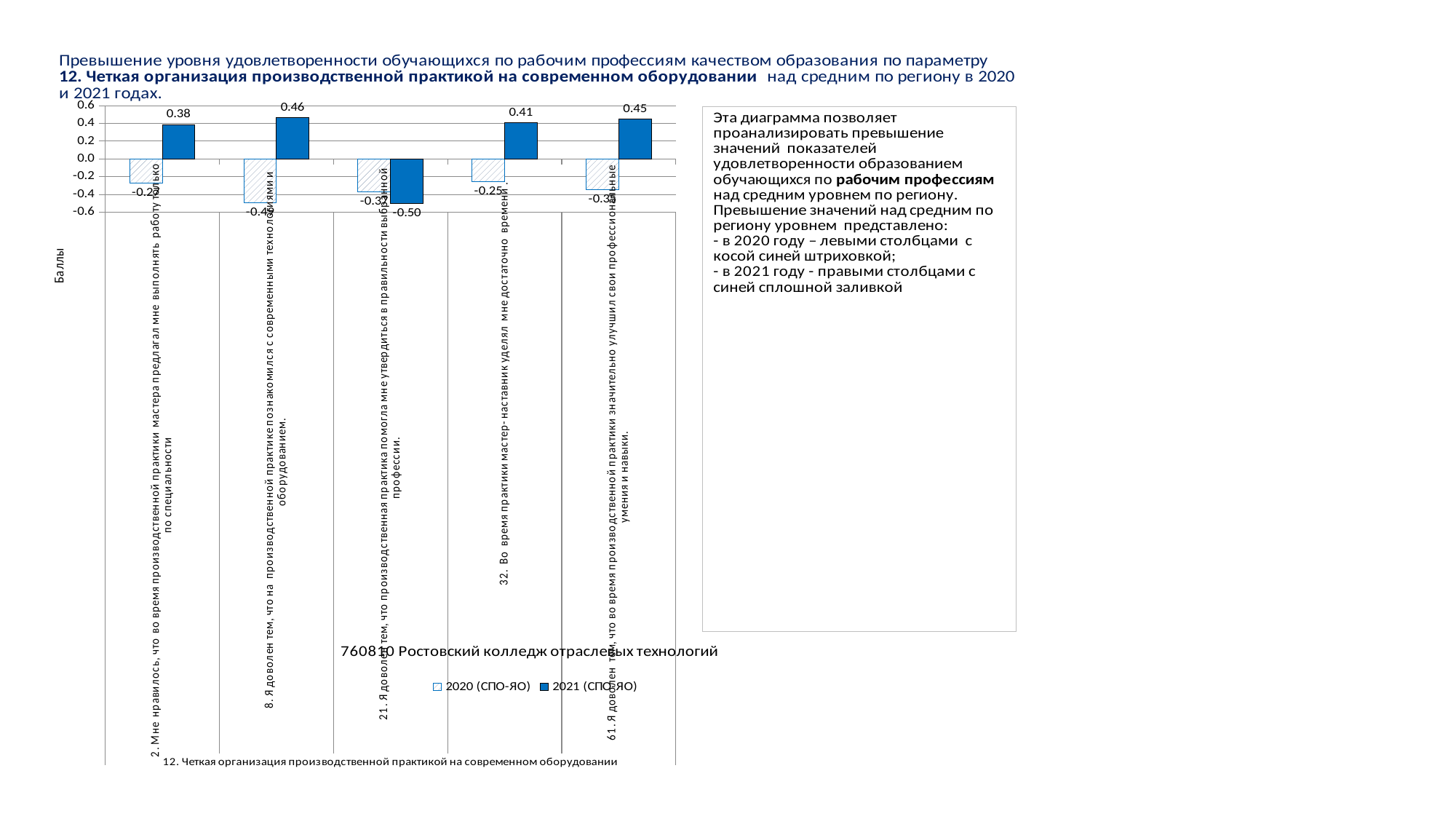
What is the 2021 (СПО-ЯО) value for category 21 ("Я доволен тем, что производственная практика помогла мне утвердиться в правильности выбранной профессии")? -0.50 How many categories (questions) are plotted on the chart? 5 What is the difference between the 2021 (СПО-ЯО) values for category 8 and category 2? 0.08 What kind of chart is shown on the slide? bar chart Which category has the lowest 2021 (СПО-ЯО) value? 21. Я доволен тем, что производственная практика помогла мне утвердиться в правильности выбранной профессии Is the 2020 (СПО-ЯО) value for category 8 greater or less than -0.2? less What is the label of the vertical axis? Баллы What is the 2021 (СПО-ЯО) value for category 8 ("Я доволен тем, что на производственной практике познакомился с современными технологиями и оборудованием")? 0.46 How many series does the chart legend list? 2 What is the 2021 (СПО-ЯО) value for category 2 ("Мне нравилось, что во время производственной практики мастера предлагал мне выполнять работу только по специальности")? 0.38 Which category has the highest 2021 (СПО-ЯО) value? 8. Я доволен тем, что на производственной практике познакомился с современными технологиями и оборудованием What is the 2020 (СПО-ЯО) value for category 32 ("Во время практики мастер-наставник уделял мне достаточно времени")? -0.25